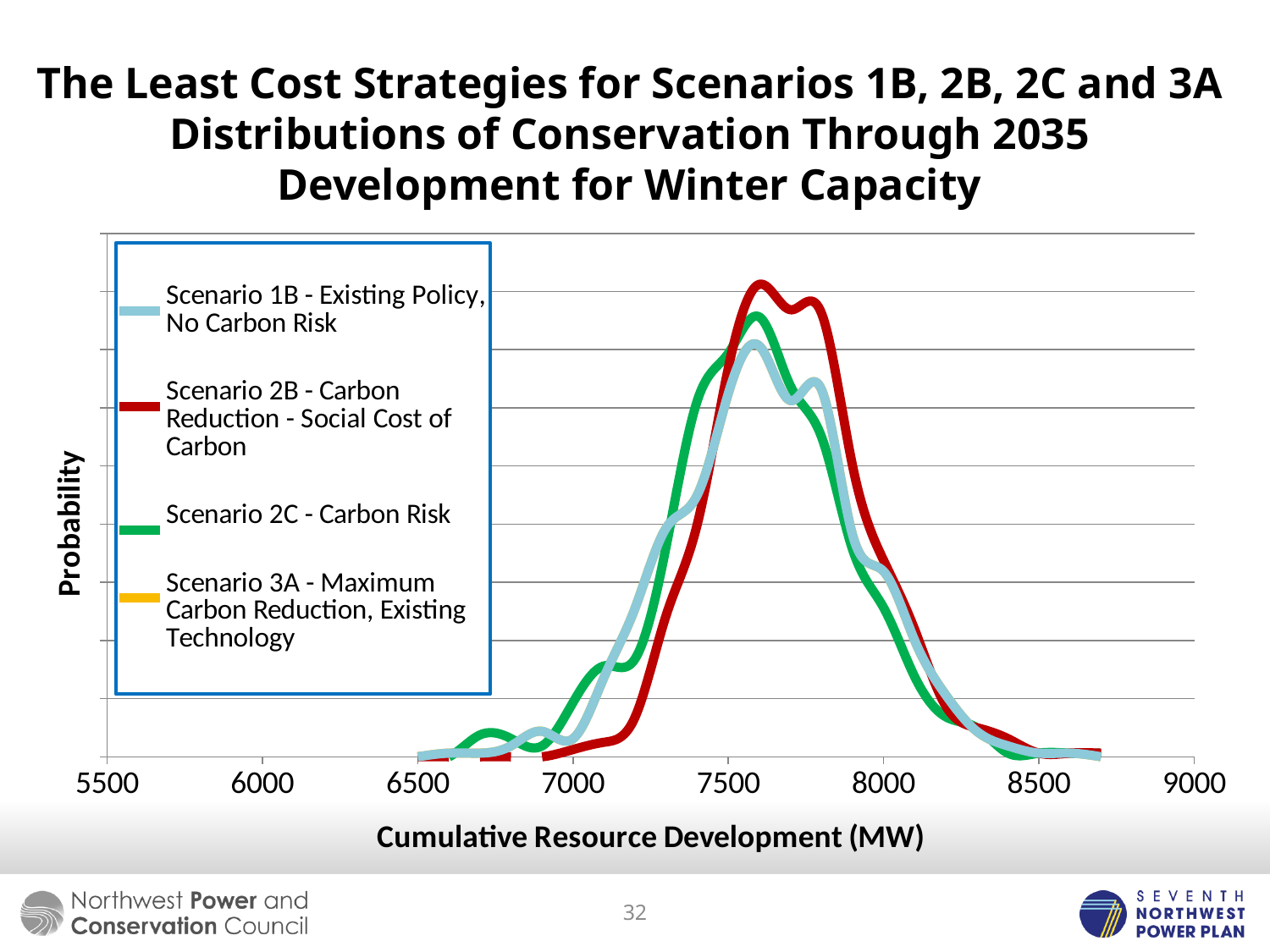
Which scenario's curve reaches the highest peak? Scenario 2B - Carbon Reduction - Social Cost of Carbon Between 8000 and 8500 MW, do the curves rise or fall? fall What is the title of the x axis? Cumulative Resource Development (MW) Is the peak of the Scenario 2B curve located at a cumulative resource development greater or less than 7500 MW? greater How many series does the legend list? 4 What is the label on the y axis? Probability What is the highest value labelled on the x axis? 9000 Between 7000 and 7500 MW, do the curves rise or fall? rise How many tick labels are shown on the x axis? 8 What kind of chart is shown on the slide? line chart Which curve reaches a higher peak, Scenario 2C - Carbon Risk or Scenario 1B - Existing Policy, No Carbon Risk? Scenario 2C - Carbon Risk What is the lowest value labelled on the x axis? 5500